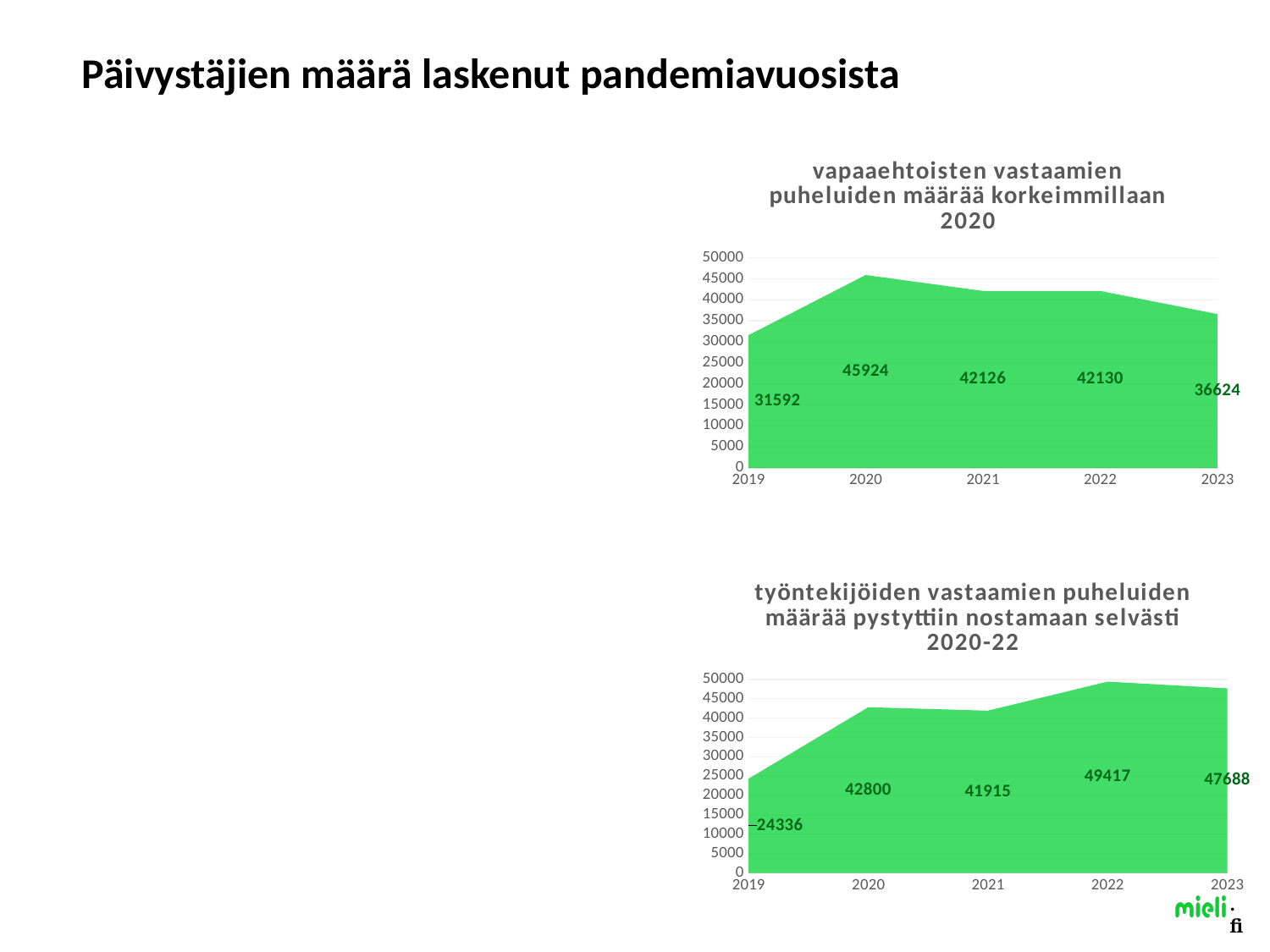
What kind of chart is the top chart on the slide? Area chart In the top chart (vapaaehtoisten vastaamien puheluiden määrää korkeimmillaan 2020), do the values rise or fall from 2020 to 2023? Fall In the top chart (vapaaehtoisten vastaamien puheluiden määrää korkeimmillaan 2020), what is the difference between the 2020 value and the 2019 value? 14332 In the bottom chart (työntekijöiden vastaamien puheluiden määrää pystyttiin nostamaan selvästi 2020-22), which year has the highest value? 2022 In the bottom chart (työntekijöiden vastaamien puheluiden määrää pystyttiin nostamaan selvästi 2020-22), which is larger, the value for 2020 or the value for 2021? 2020 In the top chart (vapaaehtoisten vastaamien puheluiden määrää korkeimmillaan 2020), what is the value for 2020? 45924 In the top chart (vapaaehtoisten vastaamien puheluiden määrää korkeimmillaan 2020), how many years are plotted? 5 In the bottom chart (työntekijöiden vastaamien puheluiden määrää pystyttiin nostamaan selvästi 2020-22), what is the value for 2019? 24336 In the bottom chart (työntekijöiden vastaamien puheluiden määrää pystyttiin nostamaan selvästi 2020-22), what is the value for 2022? 49417 In the bottom chart (työntekijöiden vastaamien puheluiden määrää pystyttiin nostamaan selvästi 2020-22), what is the difference between the 2022 value and the 2023 value? 1729 In the top chart (vapaaehtoisten vastaamien puheluiden määrää korkeimmillaan 2020), what is the value for 2023? 36624 In the top chart (vapaaehtoisten vastaamien puheluiden määrää korkeimmillaan 2020), which year has the lowest value? 2019